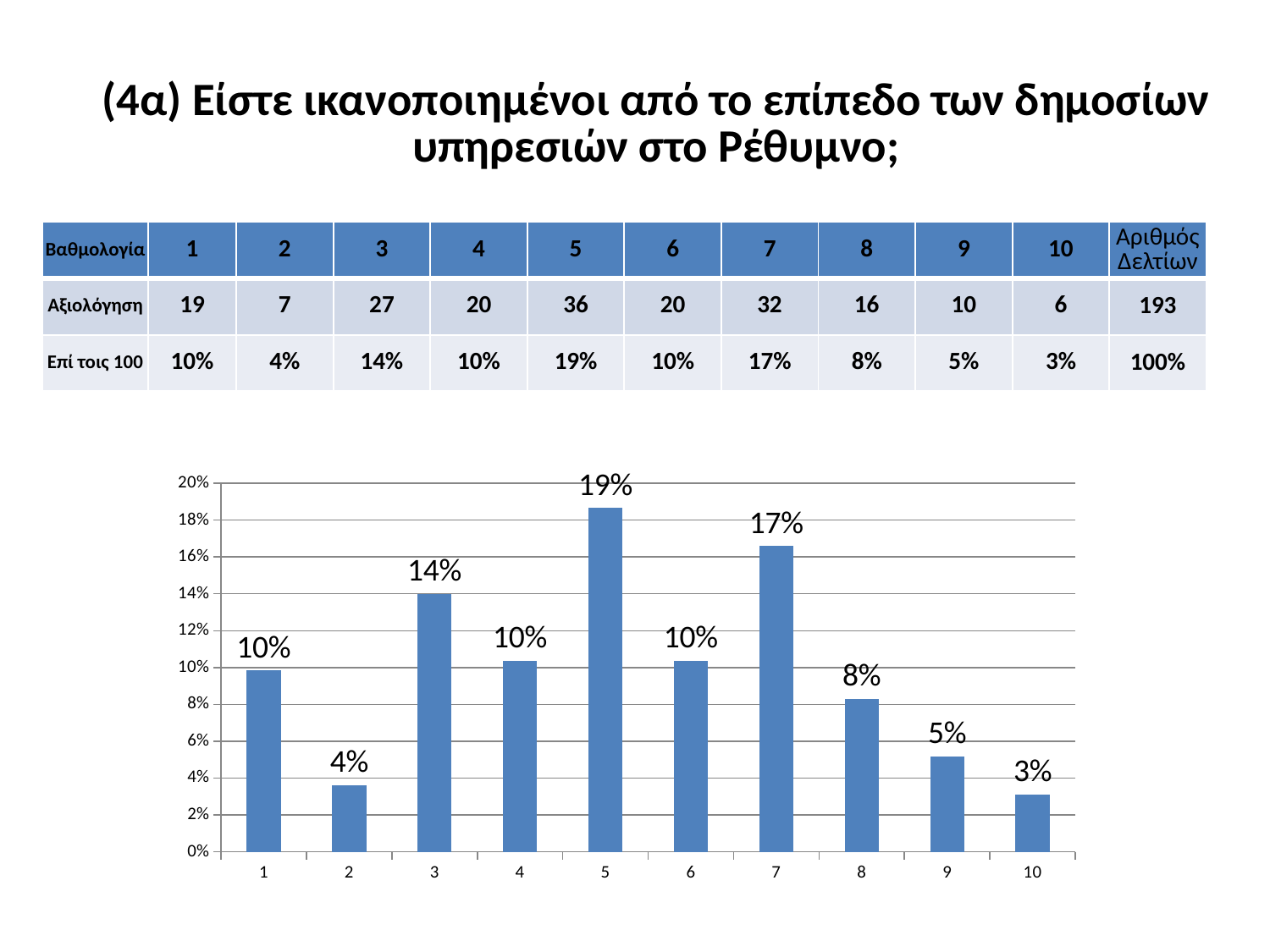
What is the difference between the values for category 5 and category 2 in the bar chart? 15% What is the value shown for category 5 in the bar chart? 19% How many categories are shown on the x axis of the bar chart? 10 What kind of chart is shown on the slide? bar chart Which category has the lowest value in the bar chart? 10 What is the value shown for category 7 in the bar chart? 17% Which category has the highest value in the bar chart? 5 What is the value shown for category 10 in the bar chart? 3% Do the values in the bar chart rise or fall from category 7 to category 10? fall What is the highest value labelled on the y axis of the bar chart? 20% Which is larger in the bar chart, the value for category 3 or the value for category 8? category 3 Is the value for category 7 greater or less than 16%? greater